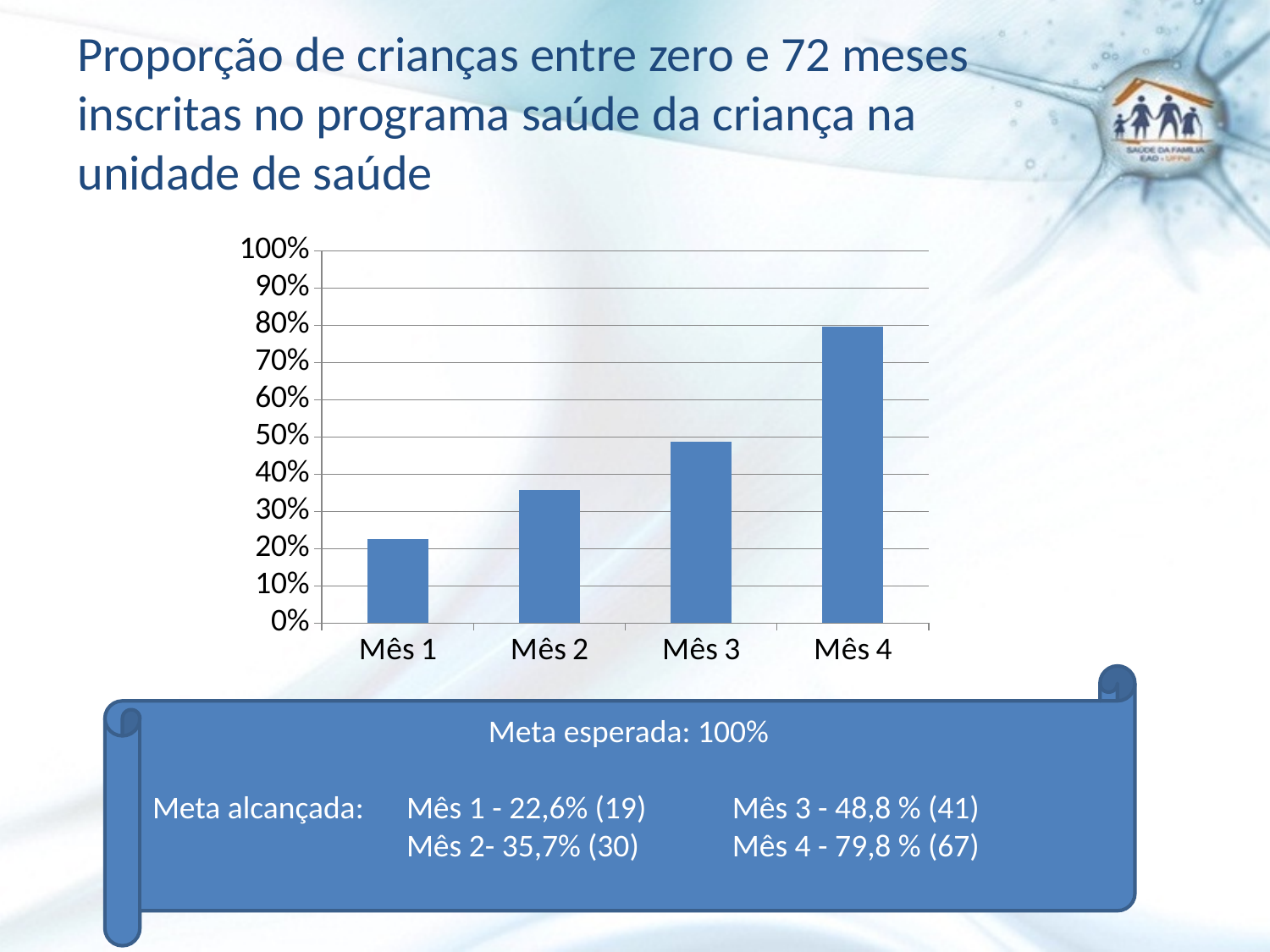
What is the expected target (meta esperada) stated on the slide? 100% Do the values rise or fall from Mês 1 to Mês 4? rise Is the value for Mês 3 greater or less than 50%? less Which is larger, the value for Mês 2 or the value for Mês 3? Mês 3 Which month has the lowest bar in the chart? Mês 1 Which month has the highest bar in the chart? Mês 4 What kind of chart is shown on the slide? bar chart According to the slide, what proportion was reached in Mês 4? 79,8 % How many months (categories) are plotted on the x axis of the chart? 4 Is the value for Mês 4 greater or less than 70%? greater According to the slide, what proportion was reached in Mês 1? 22,6% Is the value for Mês 2 greater or less than 40%? less